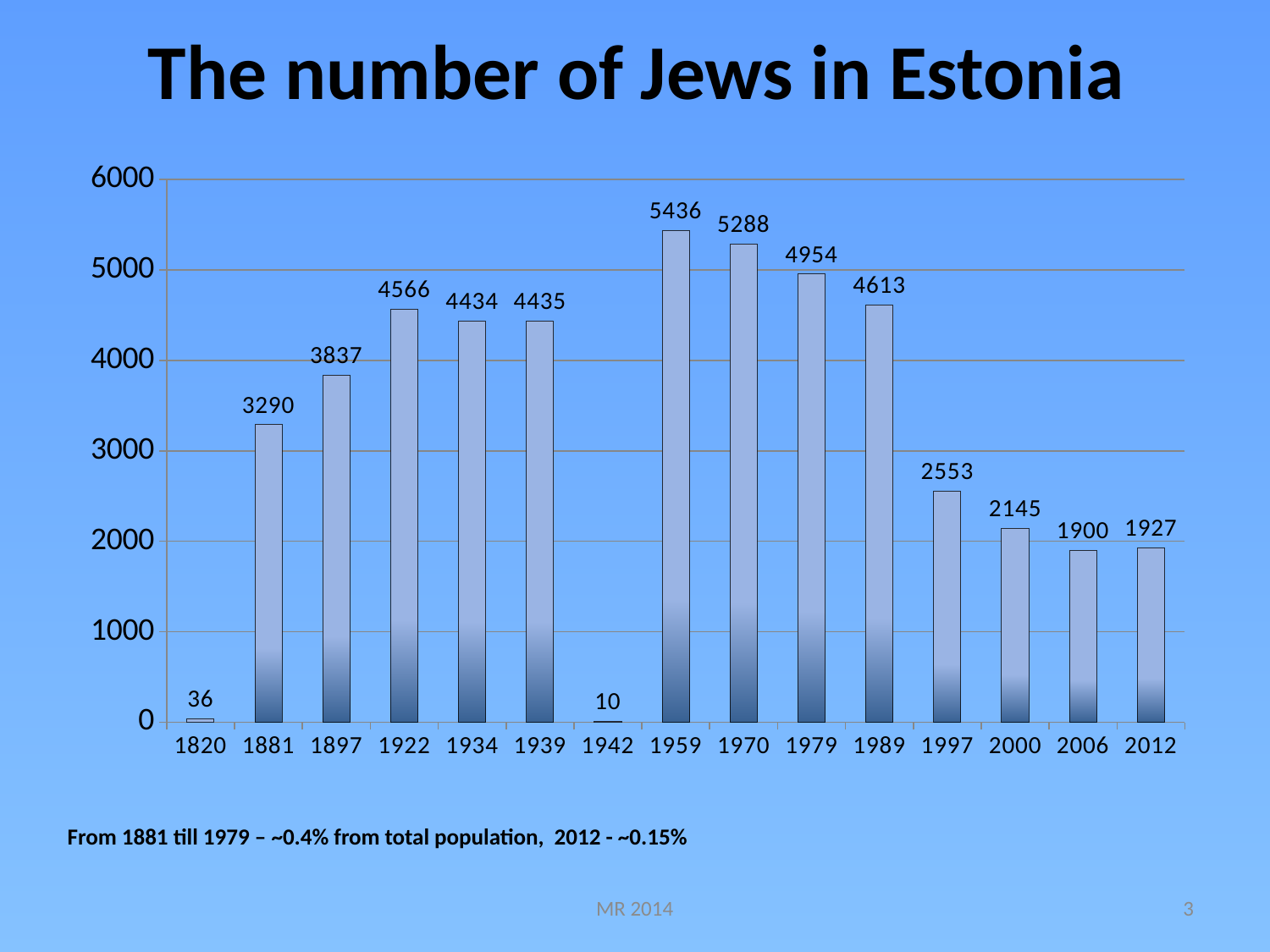
What value is shown for 1942? 10 What is the difference between the values for 1959 and 1970? 148 Which year has the highest value on the chart? 1959 What is the difference between the values for 1997 and 2000? 408 Is the value for 1989 greater or less than 4000? greater Which is larger, the value for 1922 or the value for 1934? 1922 What is the number of Jews in Estonia shown for 1959? 5436 What is the title of the chart? The number of Jews in Estonia How many years are shown on the x axis? 15 Which year has the lowest value on the chart? 1942 What kind of chart is shown on the slide? Bar chart What value is shown for 2012? 1927